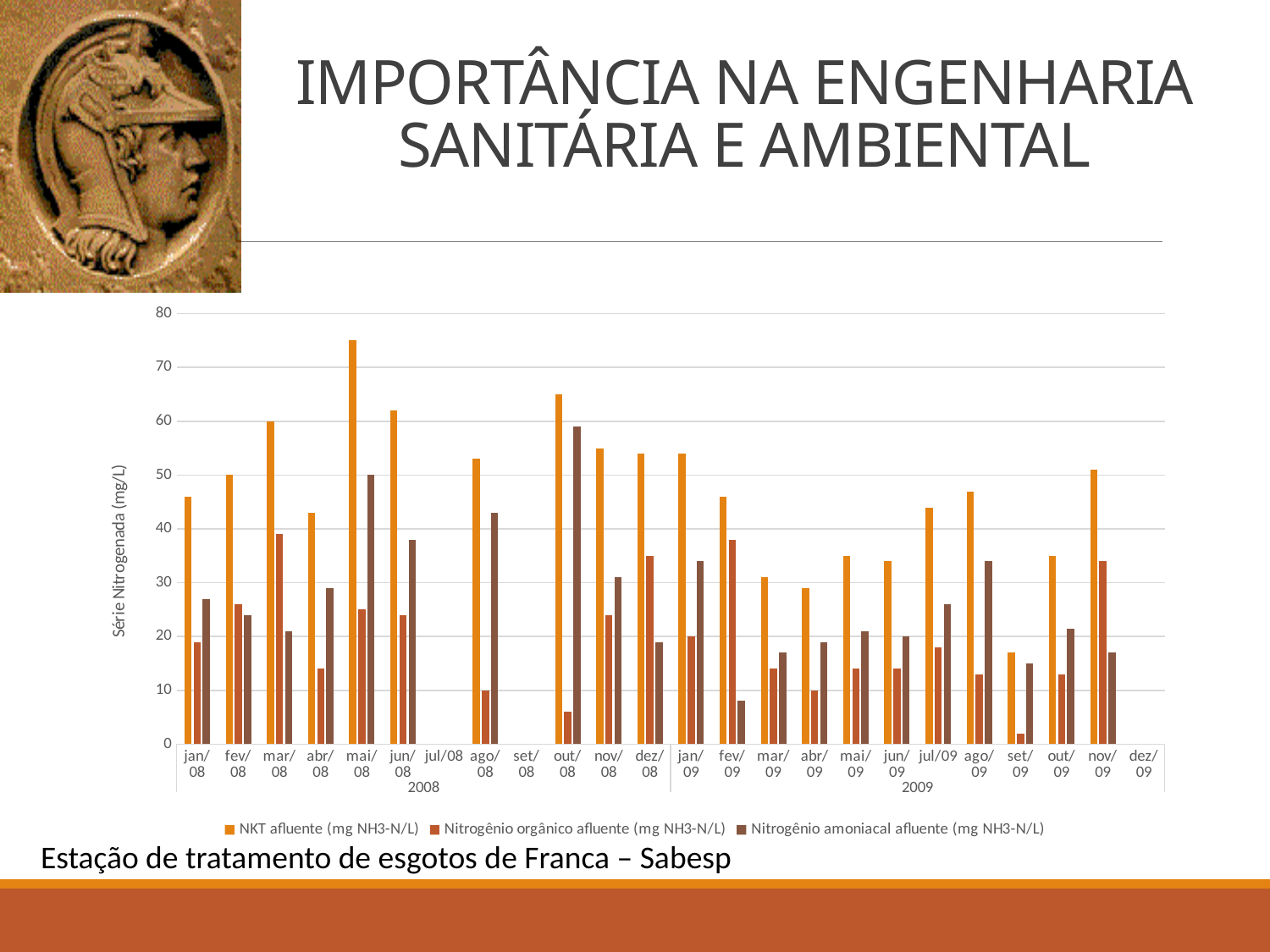
How many month categories are shown along the x axis? 24 In which month is the NKT afluente value highest? mai/08 Is the NKT afluente value for mai/08 greater or less than 70? greater Is the NKT afluente value for jan/08 greater or less than 50? less Is the Nitrogênio orgânico afluente value for out/08 greater or less than 10? less In which month is the Nitrogênio amoniacal afluente value highest? out/08 Which is larger for jun/08, the Nitrogênio amoniacal afluente value or the Nitrogênio orgânico afluente value? Nitrogênio amoniacal afluente What kind of chart is shown on the slide? bar chart Which is larger, the NKT afluente value for fev/08 or for mar/08? mar/08 How many series does the legend list? 3 What is the label on the vertical axis of the chart? Série Nitrogenada (mg/L)